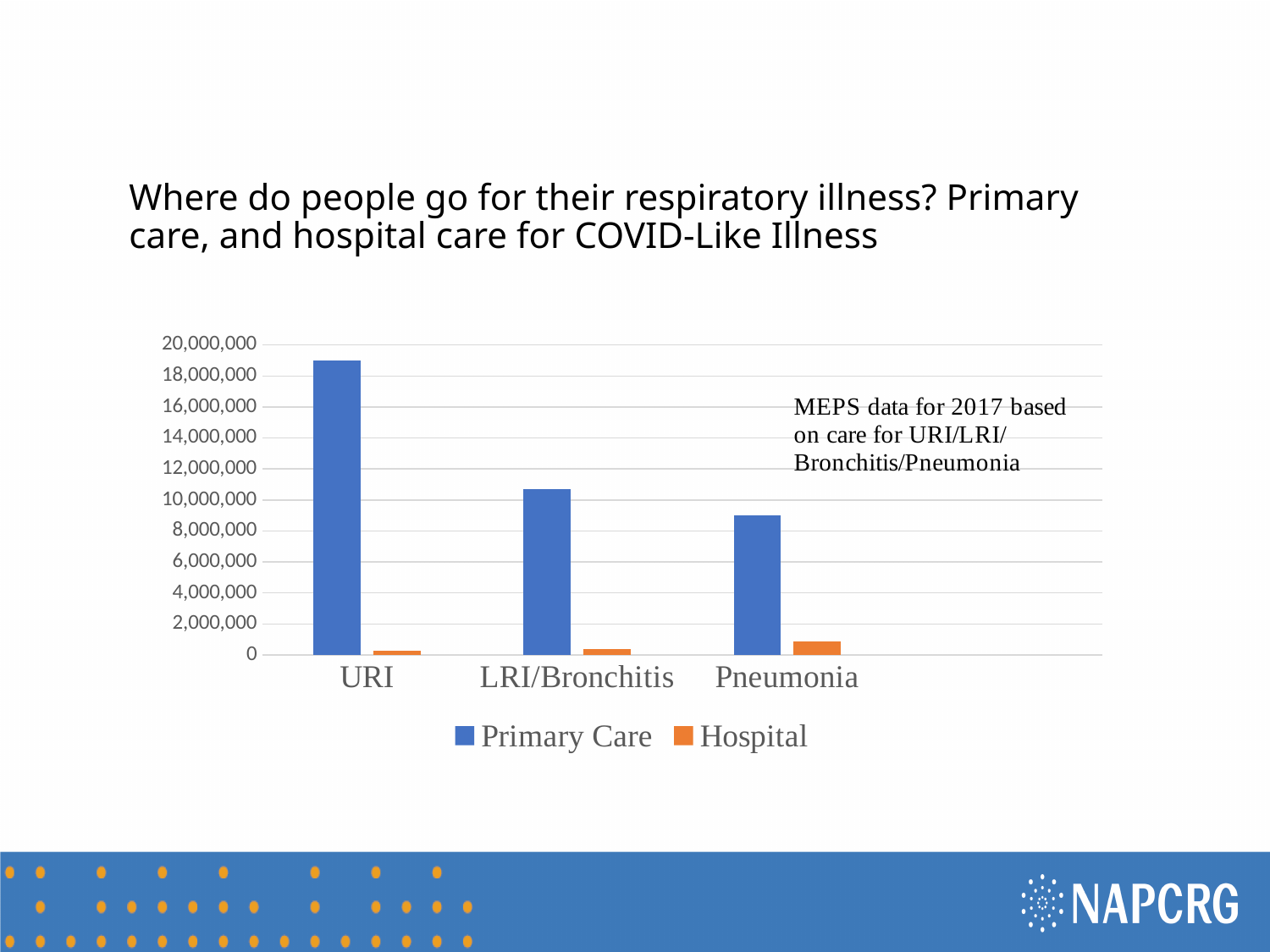
How many categories are shown on the x axis of the chart? 3 How many series does the chart's legend list? 2 Which is larger, the Hospital value for Pneumonia or the Hospital value for URI? Pneumonia Is the Primary Care value for LRI/Bronchitis greater or less than 10,000,000? greater Is the Primary Care value for Pneumonia greater or less than 10,000,000? less What kind of chart is shown on the slide? Bar chart Which category has the highest Primary Care value? URI Which category has the lowest Primary Care value? Pneumonia Is the Hospital value for Pneumonia greater or less than 2,000,000? less Do the Primary Care values rise or fall from URI to Pneumonia along the x axis? Fall Which category has the highest Hospital value? Pneumonia